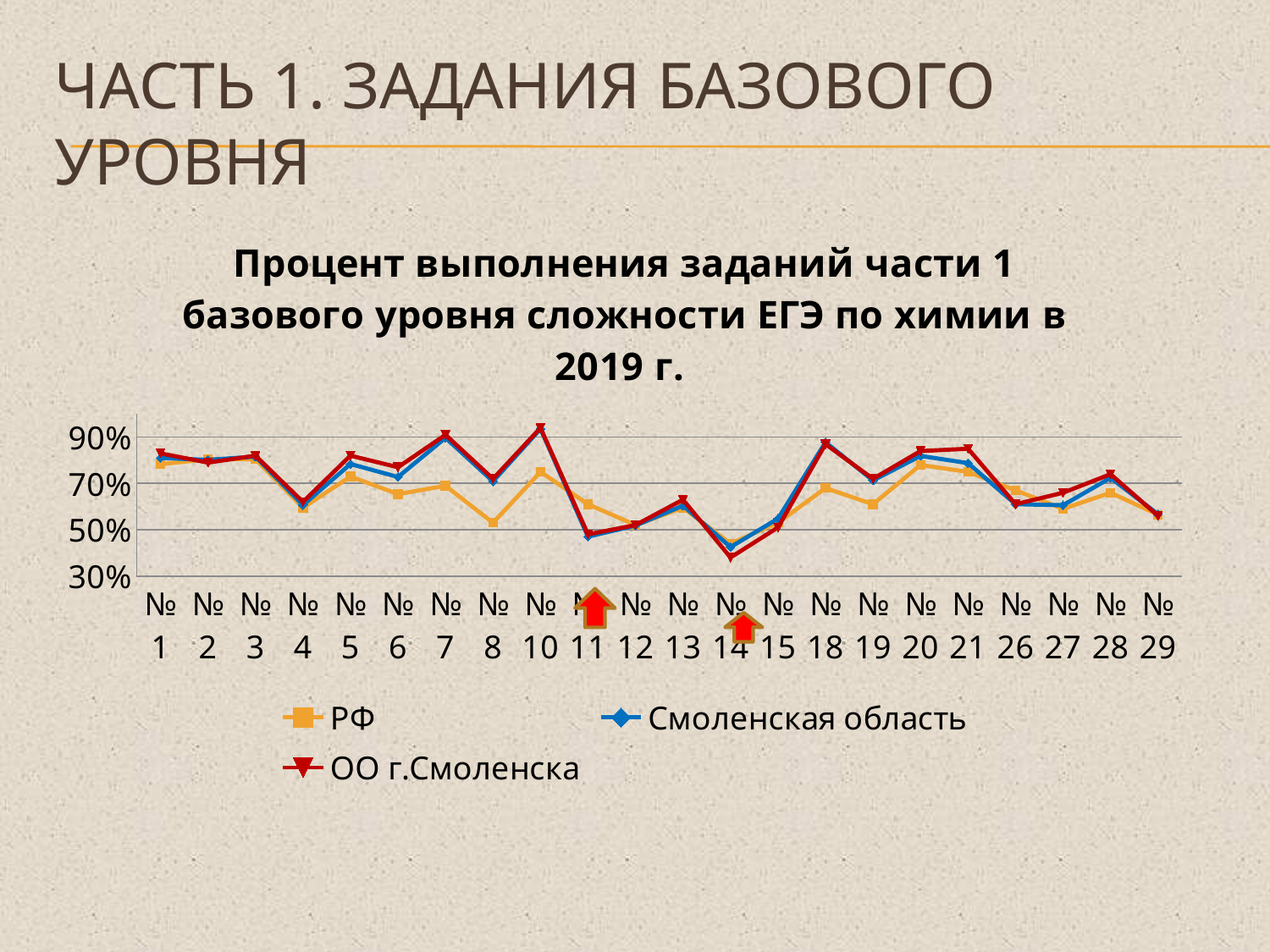
At № 8, which is larger: the value for РФ or the value for ОО г.Смоленска? ОО г.Смоленска For which task is the value for РФ lowest? № 14 For which task is the value for ОО г.Смоленска lowest? № 14 Is the value for Смоленская область at № 11 greater or less than 50%? less Does the value for ОО г.Смоленска rise or fall from № 10 to № 11? fall How many series does the legend list? 3 How many task categories are plotted along the x axis? 22 What is the title of the chart? Процент выполнения заданий части 1 базового уровня сложности ЕГЭ по химии в 2019 г. Is the value for РФ at № 8 greater or less than 70%? less Is the value for ОО г.Смоленска at № 10 greater or less than 90%? greater What kind of chart is shown on the slide? line chart Which series is drawn in red with triangle markers? ОО г.Смоленска